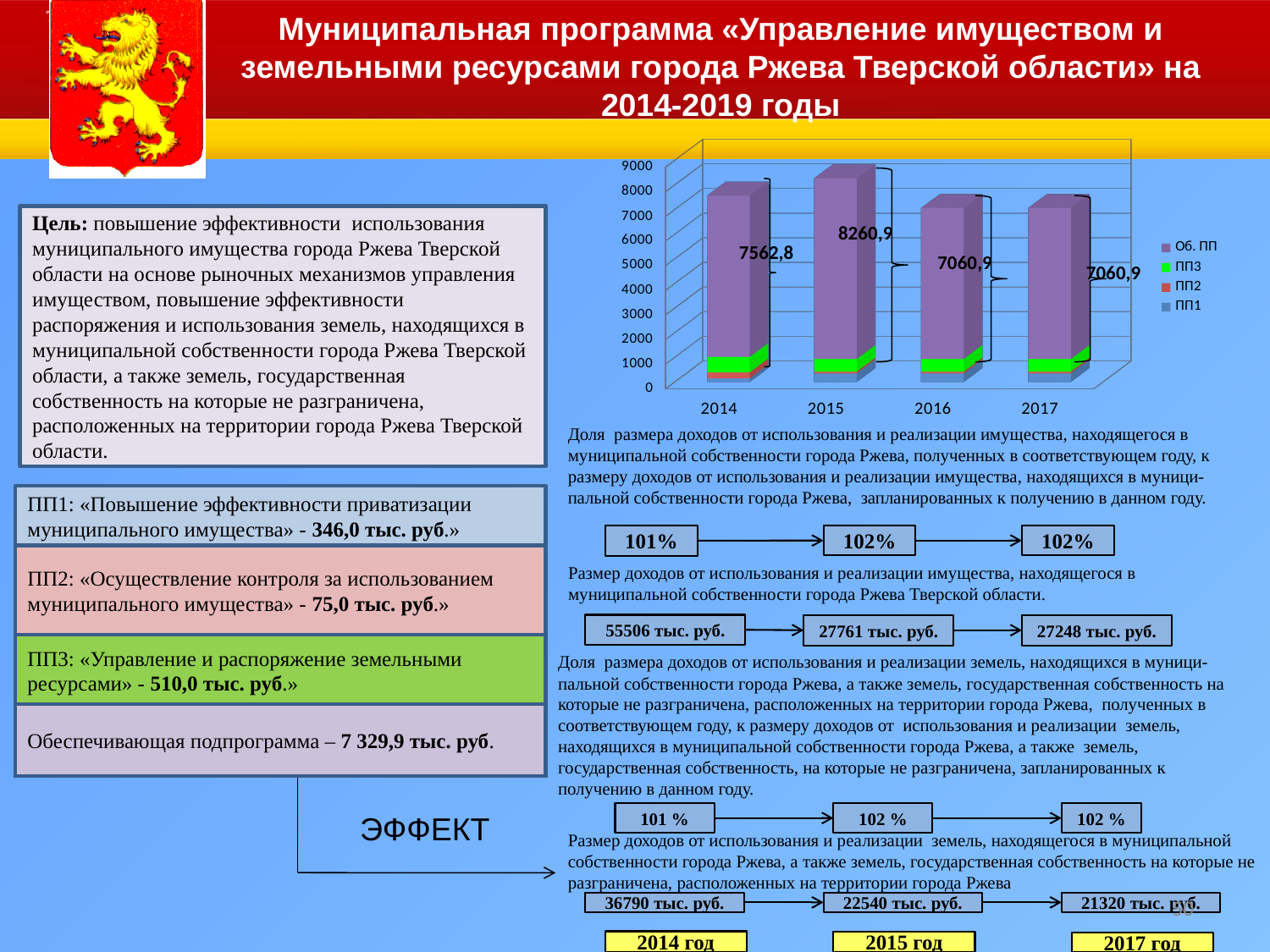
What value is labelled on the bar for 2017? 7060,9 How many series does the chart legend list? 4 Which year has the larger labelled value, 2014 or 2015? 2015 Does the labelled value rise or fall from 2015 to 2016? fall How many years are shown on the x axis of the chart? 4 What value is labelled on the bar for 2014? 7562,8 What value is labelled on the bar for 2016? 7060,9 What value is labelled on the bar for 2015? 8260,9 Which year has the highest labelled value in the chart? 2015 Is the labelled value for 2016 greater or less than 8000? less What kind of chart is shown on the slide? bar chart What is the difference between the labelled values for 2015 and 2014? 698,1